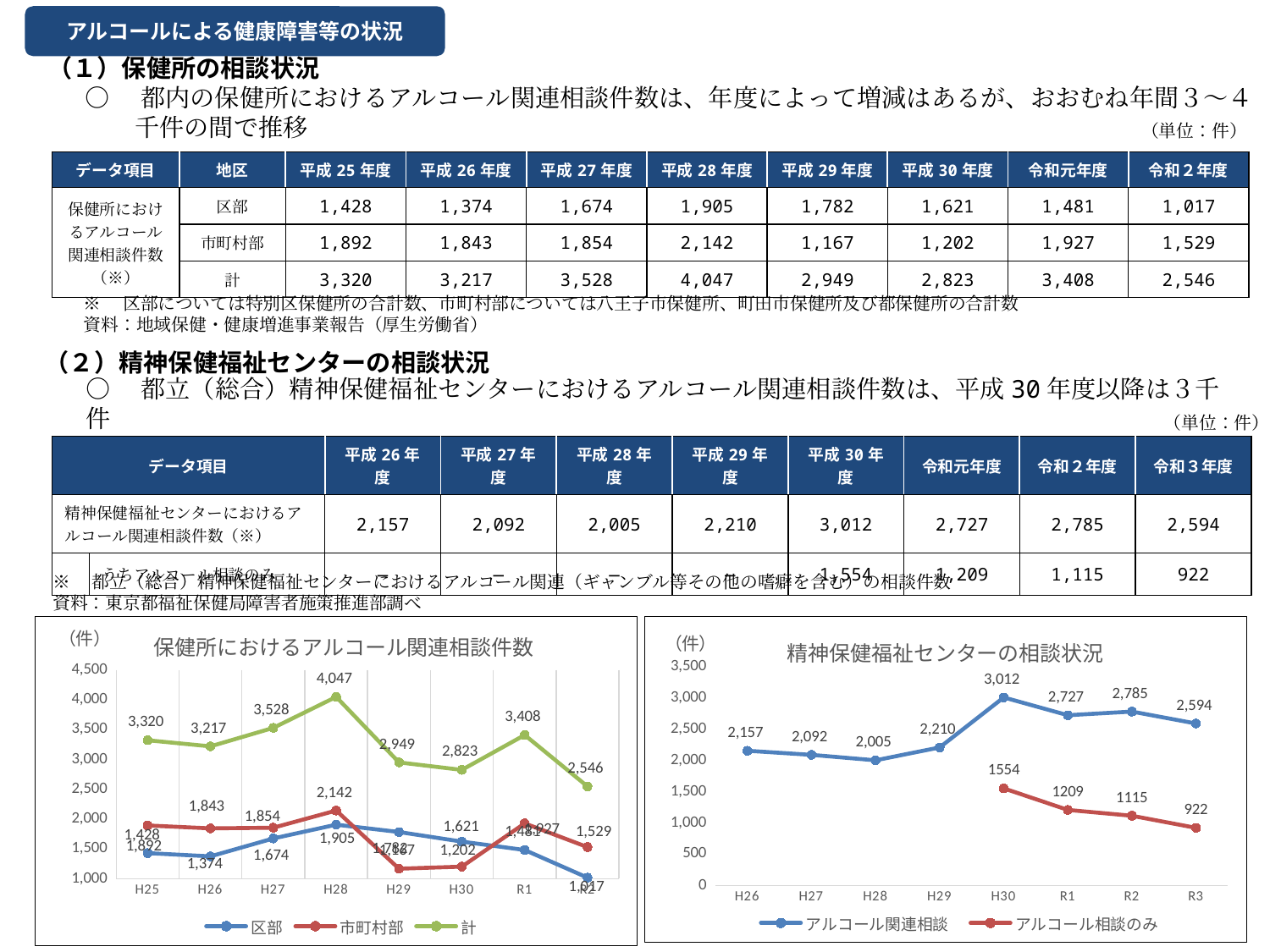
How many years are plotted on the x axis of the 精神保健福祉センターの相談状況 chart? 8 In the 保健所におけるアルコール関連相談件数 chart, is the value of 計 for R1 greater or less than 3,000? greater In the 精神保健福祉センターの相談状況 chart, which year has the highest value for アルコール関連相談? H30 In the 精神保健福祉センターの相談状況 chart, what is the value of アルコール関連相談 for H30? 3,012 In the 保健所におけるアルコール関連相談件数 chart, what is the value of 計 for H28? 4,047 What kind of chart is the 保健所におけるアルコール関連相談件数 chart on the left? line chart In the 保健所におけるアルコール関連相談件数 chart, which year has the highest value for 計? H28 In the 精神保健福祉センターの相談状況 chart, does the アルコール相談のみ series rise or fall from H30 to R3? fall In the 精神保健福祉センターの相談状況 chart, what is the value of アルコール相談のみ for R3? 922 In the 保健所におけるアルコール関連相談件数 chart, what is the difference between the 計 values for H28 and H29? 1,098 In the 保健所におけるアルコール関連相談件数 chart, which year has the lowest value for 計? R2 How many series does the legend of the 保健所におけるアルコール関連相談件数 chart list? 3